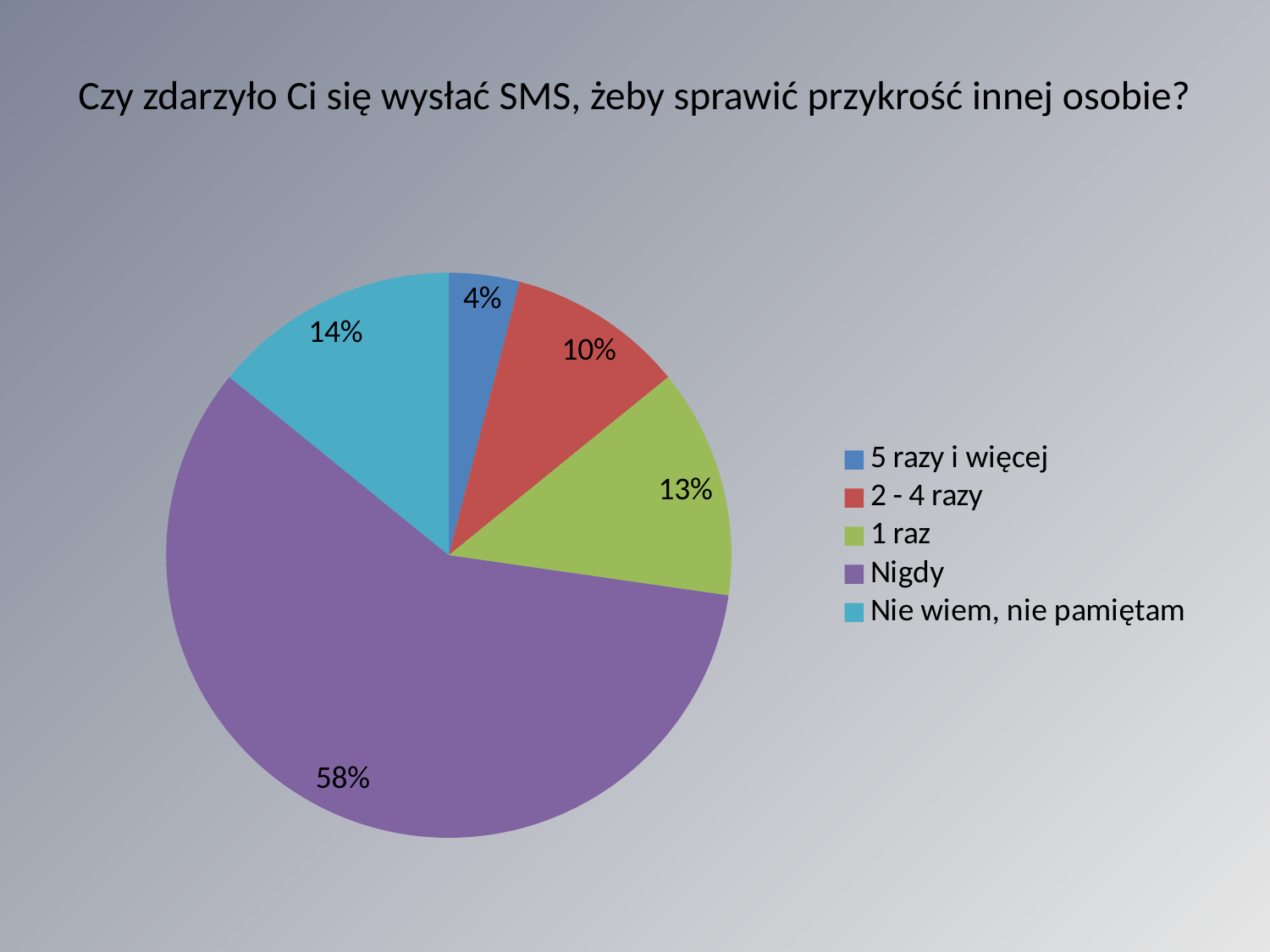
What kind of chart is shown on the slide? pie chart What is the title of the chart? Czy zdarzyło Ci się wysłać SMS, żeby sprawić przykrość innej osobie? How many categories does the pie chart have? 5 Which category has the smallest slice? 5 razy i więcej Which is larger, the value for "2 - 4 razy" or the value for "1 raz"? 1 raz What is the value for "1 raz"? 13% What is the difference between the values for "Nigdy" and "Nie wiem, nie pamiętam"? 44% Which category has the largest slice? Nigdy What share of the pie does "Nigdy" have? 58% What is the value for "Nie wiem, nie pamiętam"? 14% What is the value for "5 razy i więcej"? 4% What is the value for "2 - 4 razy"? 10%